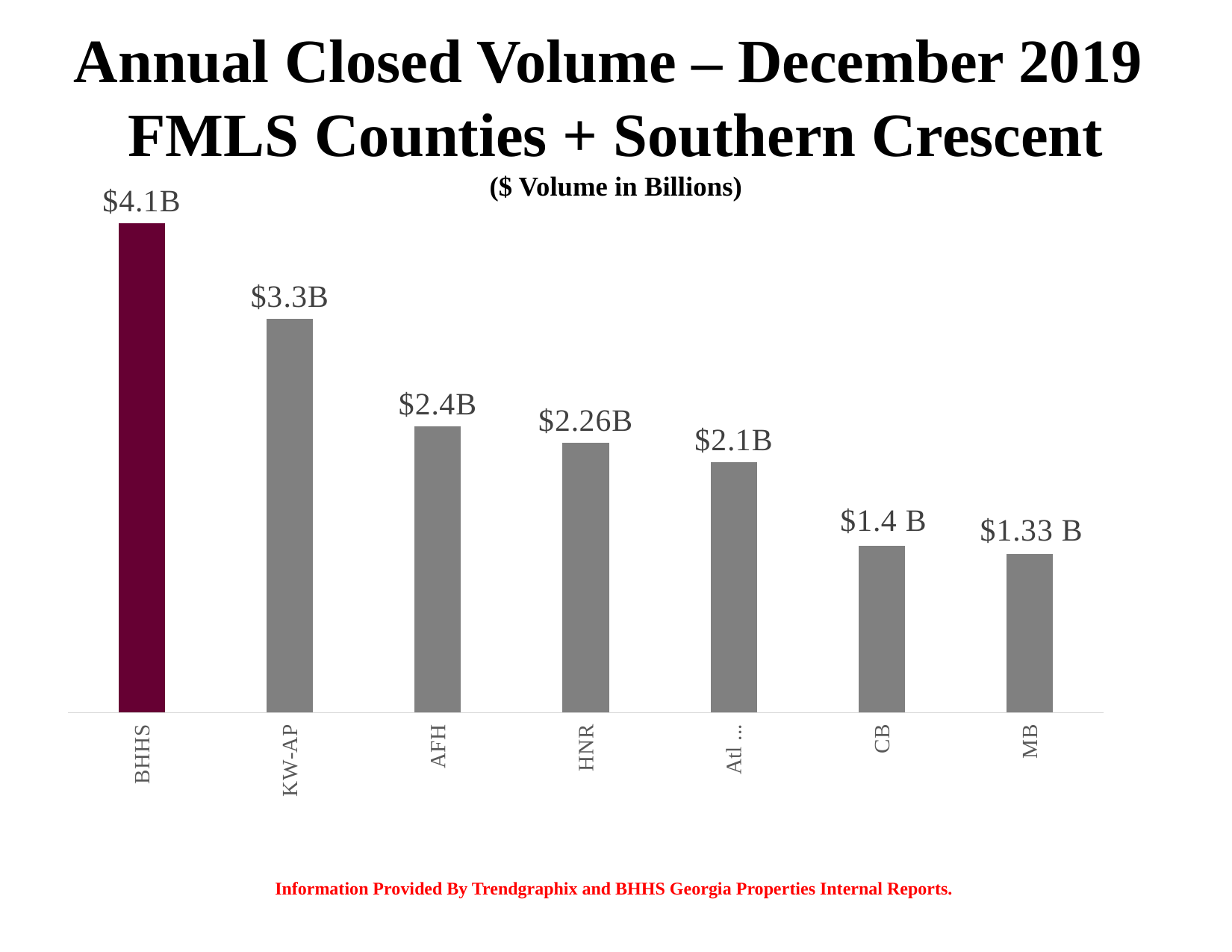
What type of chart is shown on the slide? Bar chart Do the values rise or fall from left to right across the chart? Fall Which bar is shown in a different colour from the others? BHHS What is the annual closed volume for BHHS? $4.1B What is the annual closed volume for HNR? $2.26B How much greater is the closed volume for BHHS than for KW-AP? $0.8B Which company has the lowest annual closed volume? MB Which has a larger closed volume, AFH or CB? AFH How many companies are shown in the chart? 7 What is the annual closed volume for MB? $1.33 B Which company has the highest annual closed volume? BHHS What is the annual closed volume for KW-AP? $3.3B